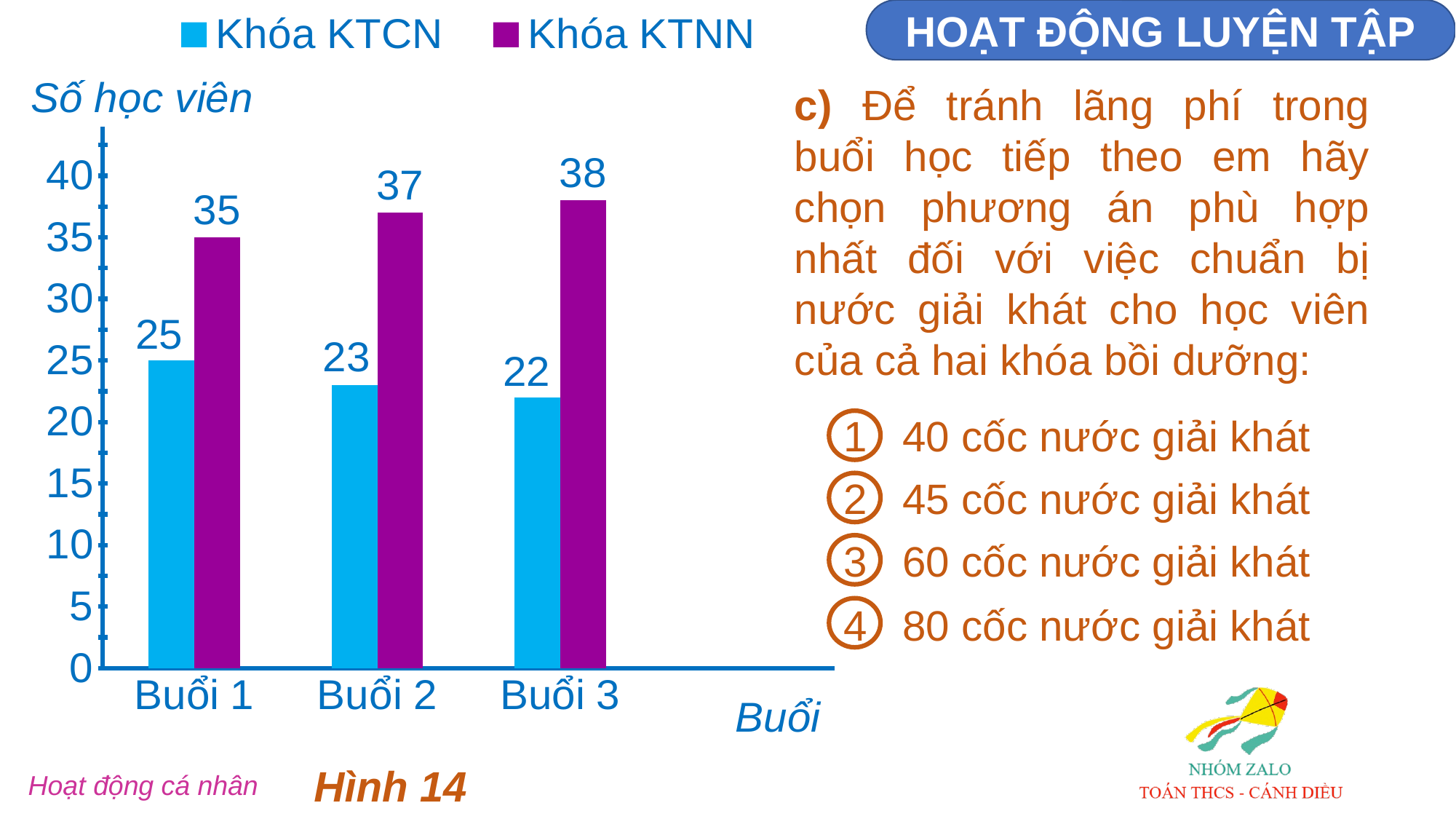
What is the value for Khóa KTNN in Buổi 3? 38 Do the values for Khóa KTCN rise or fall from Buổi 1 to Buổi 3? Fall What is the value for Khóa KTCN in Buổi 1? 25 What is the value for Khóa KTNN in Buổi 2? 37 How many sessions (Buổi) are shown on the x axis? 3 Which session (Buổi) has the highest value for Khóa KTNN? Buổi 3 Which session (Buổi) has the lowest value for Khóa KTCN? Buổi 3 What is the difference between Khóa KTNN and Khóa KTCN in Buổi 3? 16 How many series does the legend list? 2 Which is larger in Buổi 2: Khóa KTCN or Khóa KTNN? Khóa KTNN What kind of chart is shown? Bar chart What is the difference between Khóa KTNN and Khóa KTCN in Buổi 1? 10